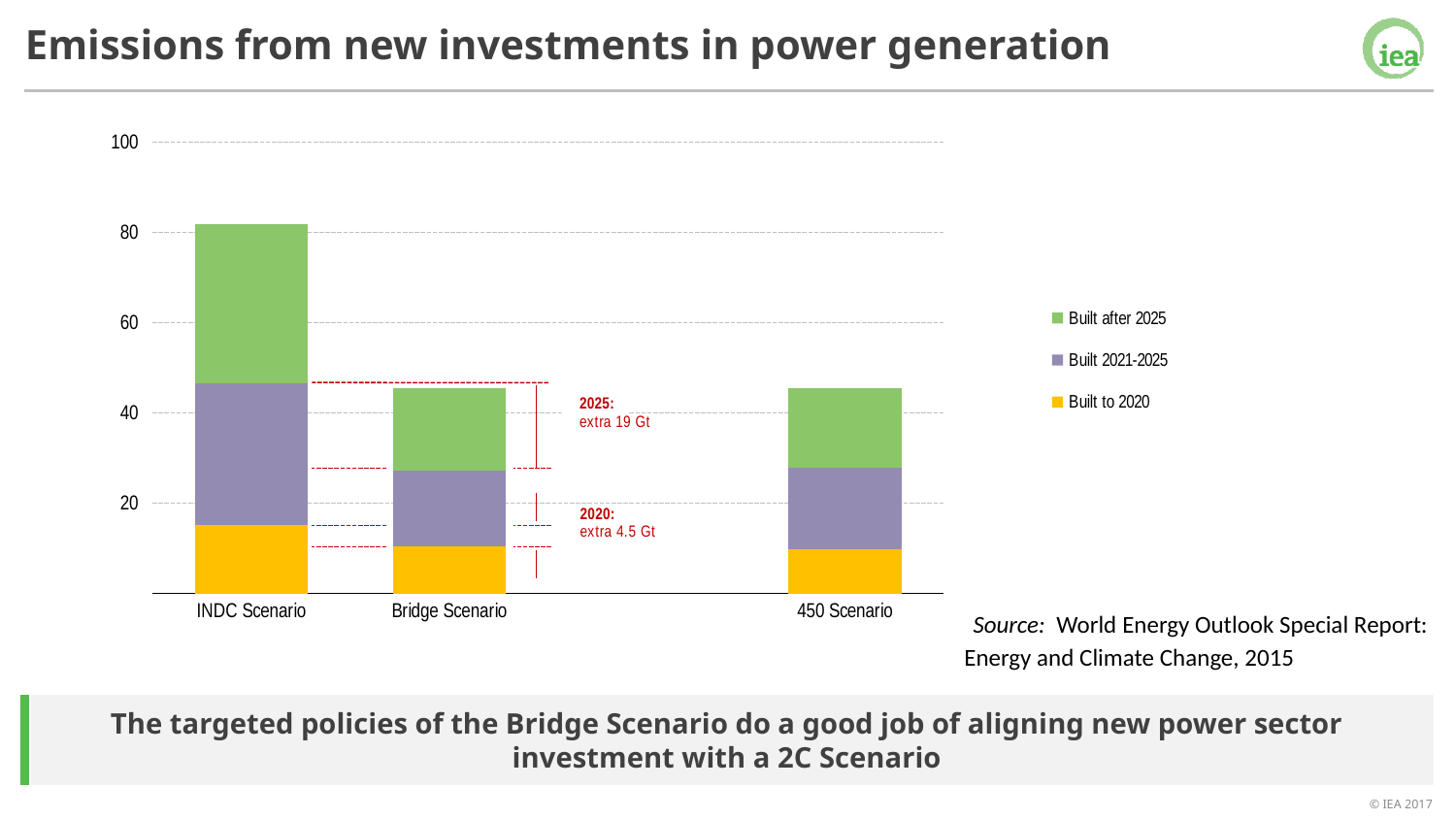
How many series does the legend list? 3 Is the total for the 450 Scenario greater or less than 60? less Which legend entry is shown in green? Built after 2025 What kind of chart is shown on the slide? Stacked bar chart According to the annotation, how much extra emissions does the INDC Scenario have compared with the Bridge Scenario by 2025? extra 19 Gt Is the total for the Bridge Scenario greater or less than 60? less Is the 'Built to 2020' value for the INDC Scenario greater or less than 20? less Which is larger, the 'Built to 2020' value for the INDC Scenario or for the Bridge Scenario? INDC Scenario How many scenarios (categories) are plotted on the x axis? 3 Which scenario has the highest total stacked bar? INDC Scenario